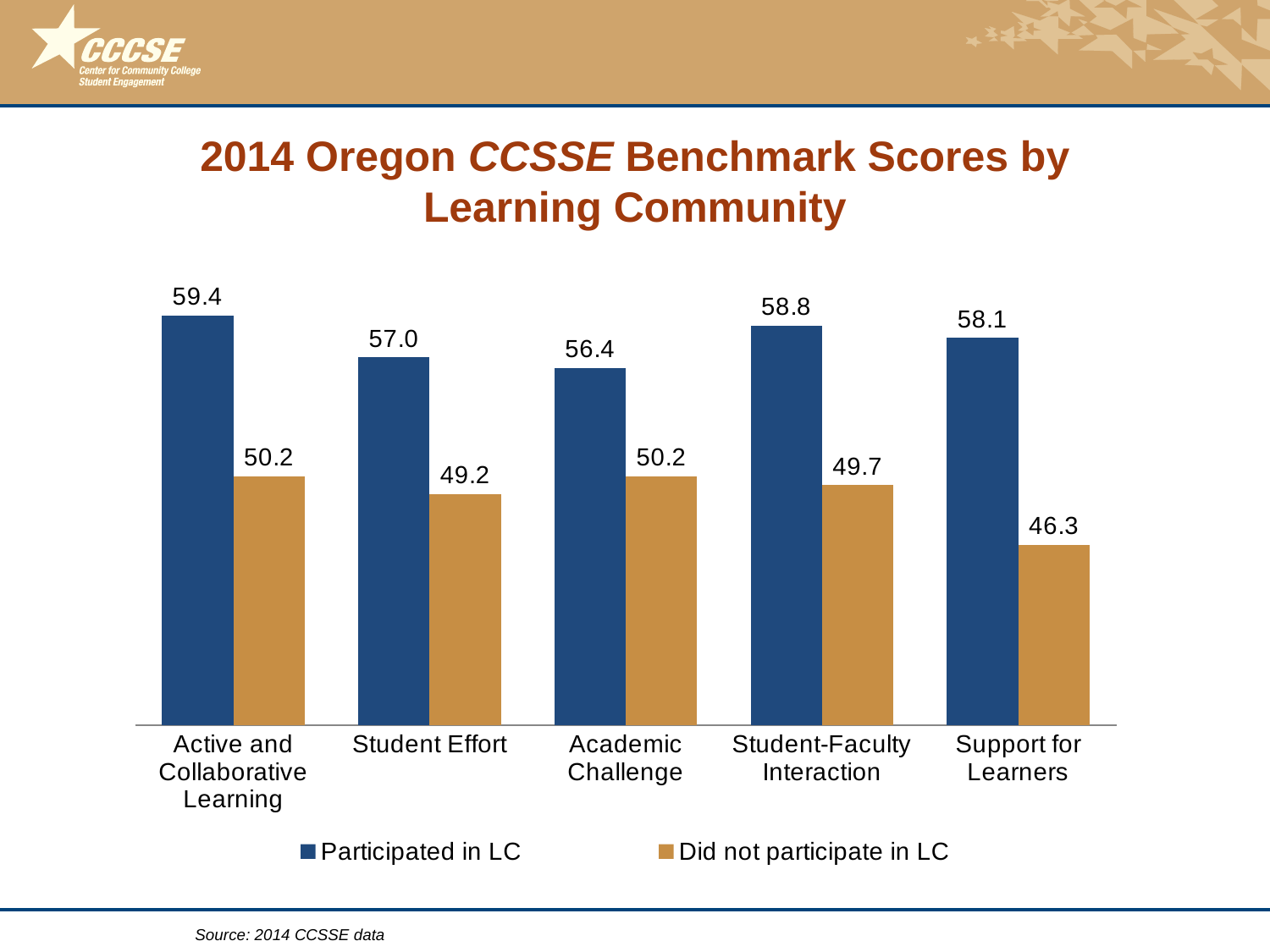
Which benchmark has the lowest score for students who did not participate in LC? Support for Learners What colour are the bars for students who did not participate in LC? Orange For Academic Challenge, which group has the higher score: Participated in LC or Did not participate in LC? Participated in LC What is the Student-Faculty Interaction score for students who did not participate in LC? 49.7 What is the difference between the Participated in LC and Did not participate in LC scores for Student Effort? 7.8 What kind of chart is shown on the slide? Bar chart What is the difference between the Participated in LC and Did not participate in LC scores for Support for Learners? 11.8 What is the benchmark score for students who did not participate in LC in Support for Learners? 46.3 What is the benchmark score for students who participated in LC in Active and Collaborative Learning? 59.4 How many series does the legend list? 2 Which benchmark has the highest score for students who participated in LC? Active and Collaborative Learning How many benchmark categories are shown on the chart? 5